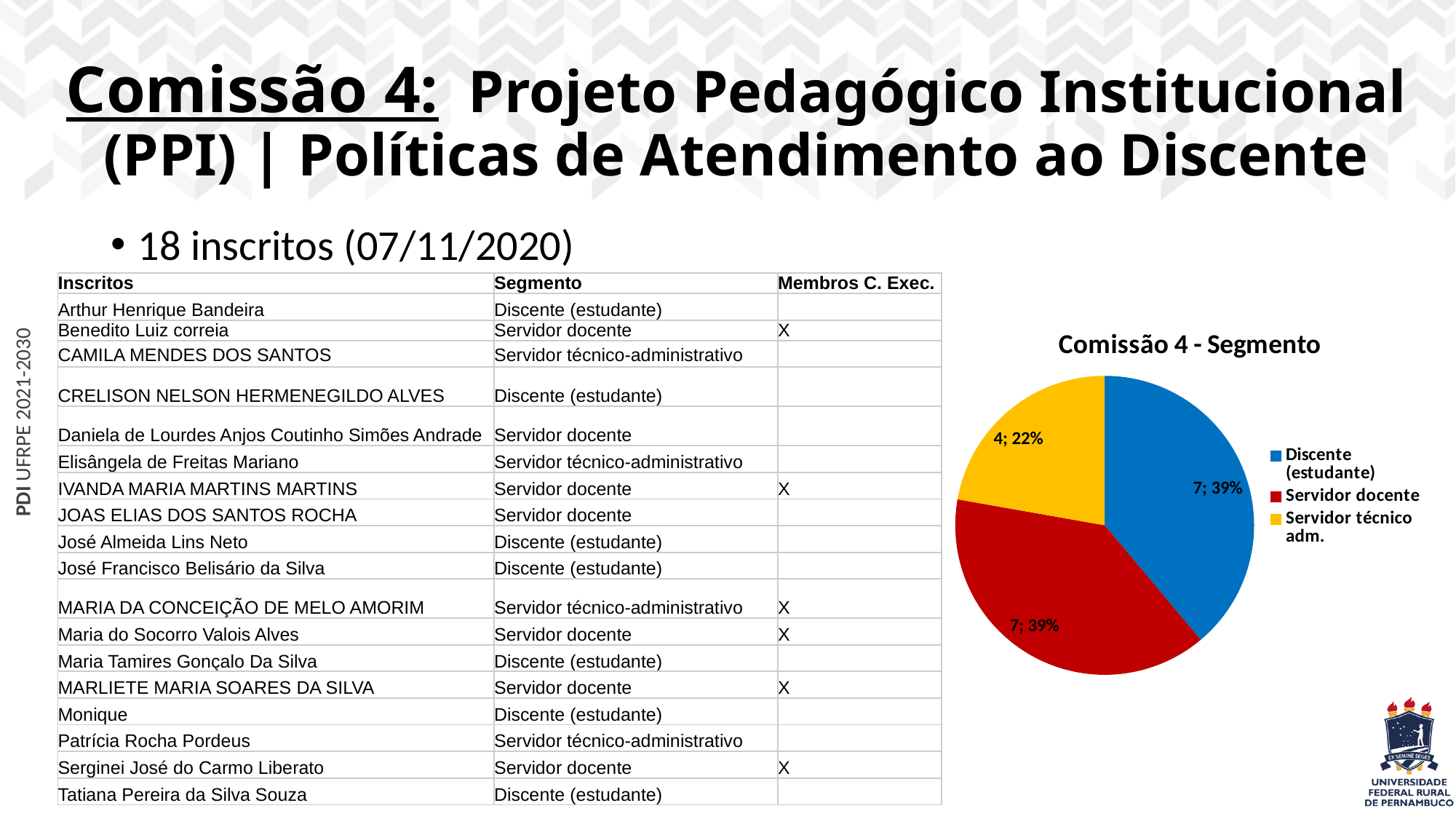
What is the title of the chart on the slide? Comissão 4 - Segmento What is the count shown for the Discente (estudante) slice? 7 How many entries does the legend of the pie chart list? 3 What kind of chart is shown on the slide? Pie chart Which colour represents Servidor docente in the pie chart? Red What is the difference in count between the Discente (estudante) slice and the Servidor técnico adm. slice? 3 How many slices does the pie chart have? 3 Which is larger, the Servidor docente slice or the Servidor técnico adm. slice? Servidor docente What is the count shown for the Servidor técnico adm. slice? 4 What percentage share does the Servidor técnico adm. slice have? 22% What percentage share does the Servidor docente slice have? 39% Which segment has the smallest slice in the pie chart? Servidor técnico adm.